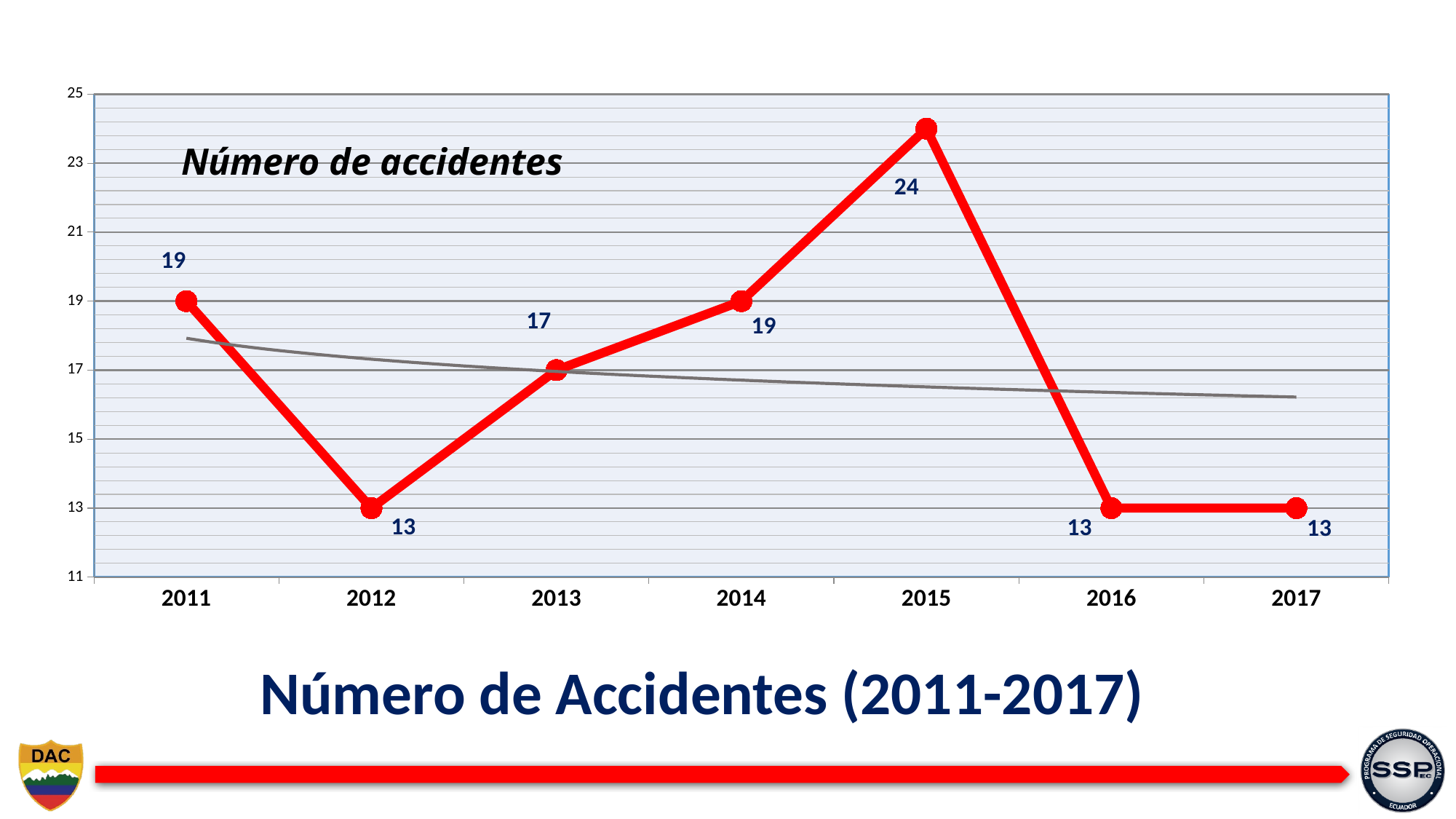
What is the difference in the number of accidents between 2015 and 2016? 11 What is the difference in the number of accidents between 2011 and 2012? 6 How many years are plotted on the x axis? 7 What kind of chart is shown on the slide? line chart Does the number of accidents rise or fall from 2015 to 2016? fall Which year has more accidents, 2014 or 2013? 2014 What is the title shown inside the chart area? Número de accidentes What is the number of accidents in 2013? 17 What is the number of accidents in 2011? 19 What is the number of accidents in 2015? 24 Is the number of accidents in 2015 greater or less than 21? greater Which year has the highest number of accidents? 2015